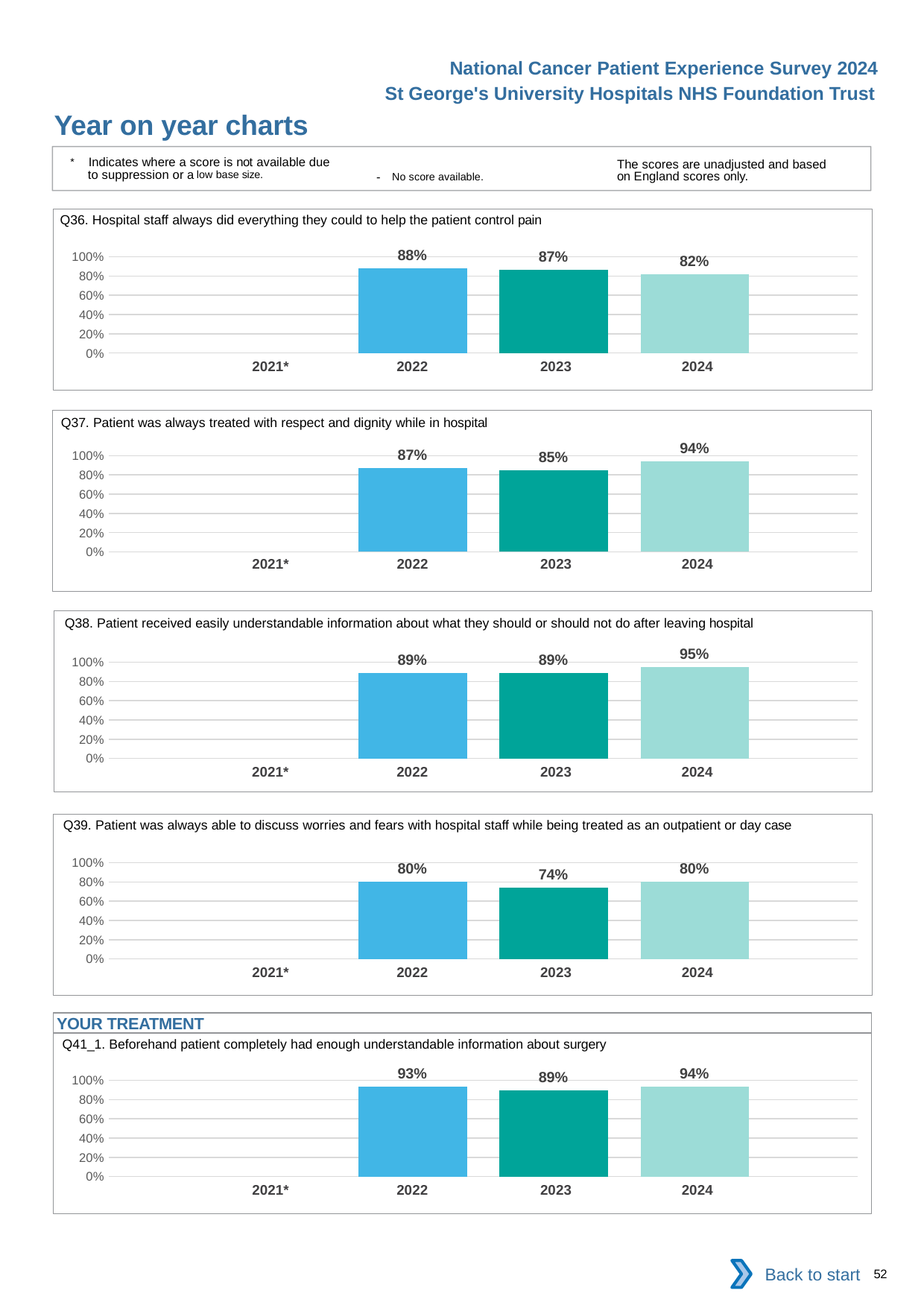
In the Q36 chart, which year has the highest value? 2022 In the Q38 chart, what is the value for 2022? 89% In the Q37 chart, what is the difference between the 2024 and 2023 values? 9% In the Q41_1 chart, what is the difference between the 2022 and 2023 values? 4% In the Q41_1 chart, what is the value for 2022? 93% In the Q39 chart, which year has the lowest value? 2023 In the Q36 chart, what is the value for 2024? 82% In the Q37 chart, which year has the lowest value? 2023 What kind of chart is the Q36 chart? Bar chart In the Q39 chart, what is the value for 2023? 74% How many year categories are shown on the x axis of the Q39 chart? 4 In the Q38 chart, is the value for 2024 larger than the value for 2023? Yes